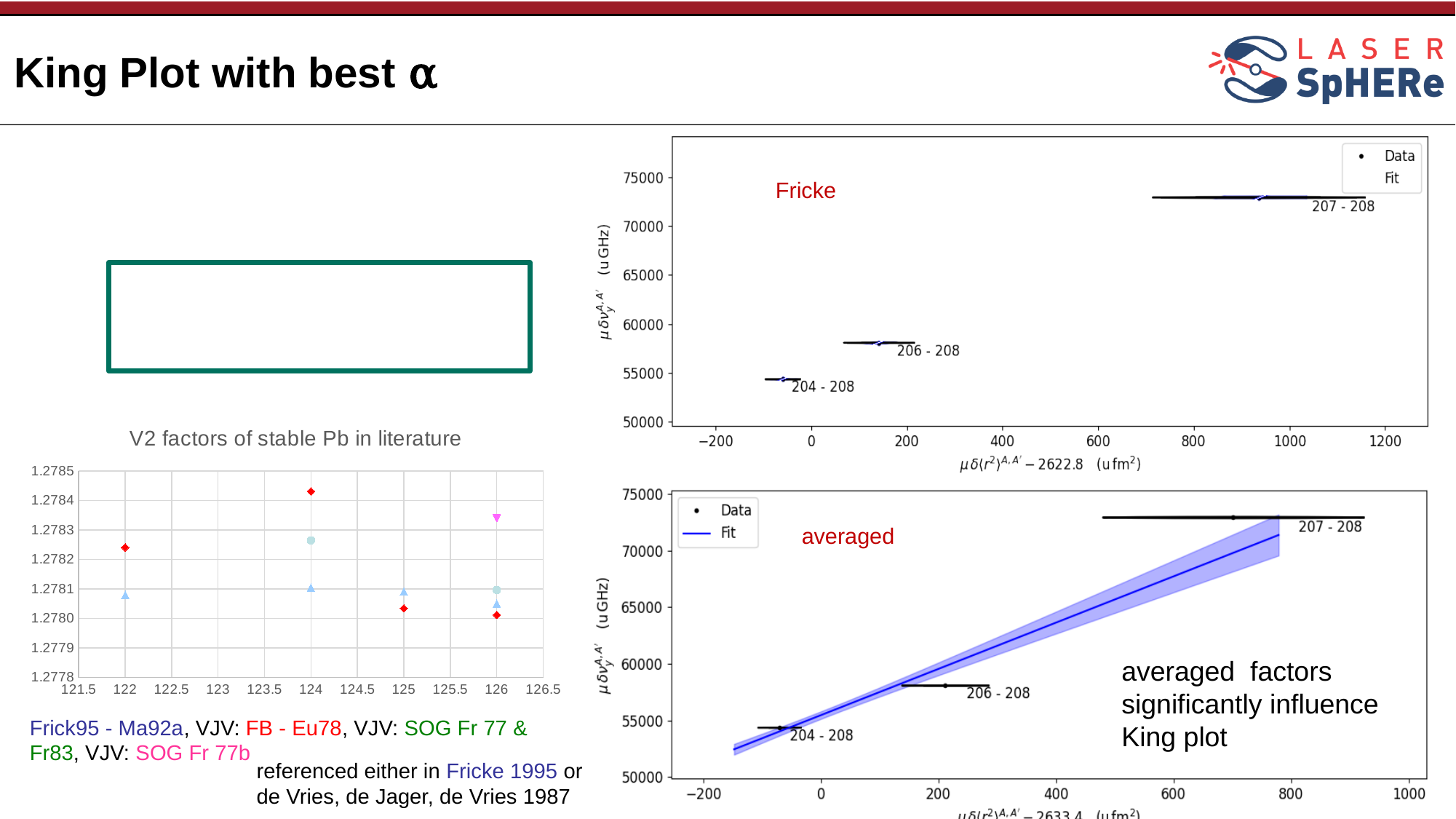
What kind of chart is the 'V2 factors of stable Pb in literature' chart? scatter plot In the 'Fricke' King plot (top right), is the value for 207 - 208 greater or less than 70000? greater In the 'averaged' King plot (bottom right), is the value for 206 - 208 greater or less than 60000? less In the 'Fricke' King plot (top right), how many labelled isotope-pair data points are plotted? 3 What is the title of the chart on the bottom left of the slide? V2 factors of stable Pb in literature In the 'averaged' King plot (bottom right), what colour is the fit line? blue In the 'Fricke' King plot (top right), which isotope pair has the highest value? 207 - 208 In the 'averaged' King plot (bottom right), do the data values rise or fall as the x value increases? rise In the 'averaged' King plot (bottom right), which is larger, the value for 206 - 208 or the value for 204 - 208? 206 - 208 In the 'averaged' King plot (bottom right), how many entries does the legend list? 2 In the 'Fricke' King plot (top right), which isotope pair has the lowest value? 204 - 208